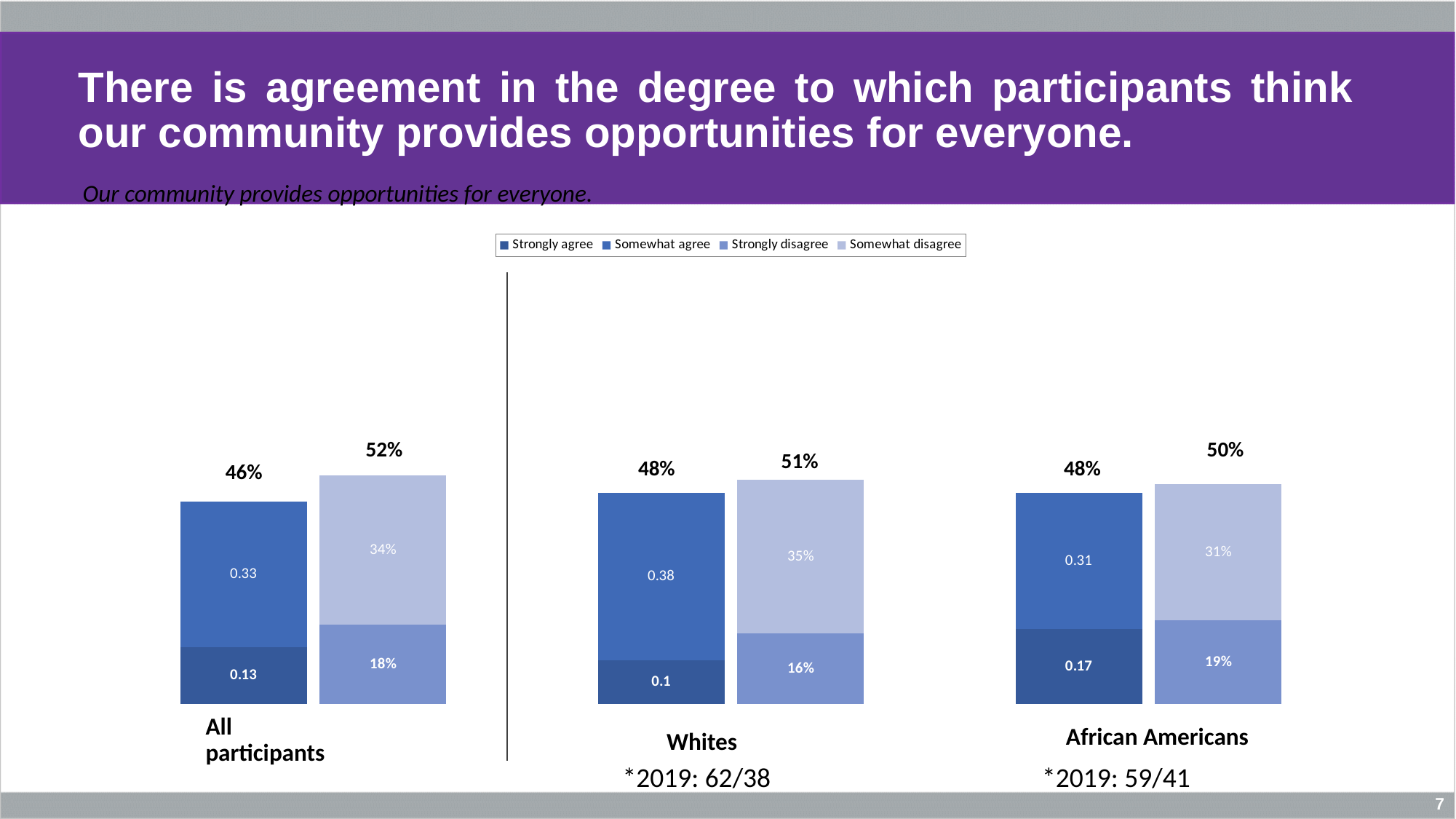
In the All participants chart, what value is shown for the Strongly agree segment? 0.13 What kind of chart is used on this slide? stacked bar chart In the Whites chart, what value is shown for the Somewhat agree segment? 0.38 In the Whites chart, what value is shown for the Strongly disagree segment? 16% In the Whites chart, what is the difference between the disagree bar total (51%) and the agree bar total (48%)? 3% How many series does the legend list? 4 In the African Americans chart, what is the total labelled above the disagree bar? 50% In the African Americans chart, which bar has the larger total, the agree bar or the disagree bar? the disagree bar In the All participants chart, what value is shown for the Somewhat disagree segment? 34% In the All participants chart, what is the total labelled above the disagree bar? 52% In the All participants chart, what is the total labelled above the agree bar? 46% In the African Americans chart, what value is shown for the Strongly agree segment? 0.17